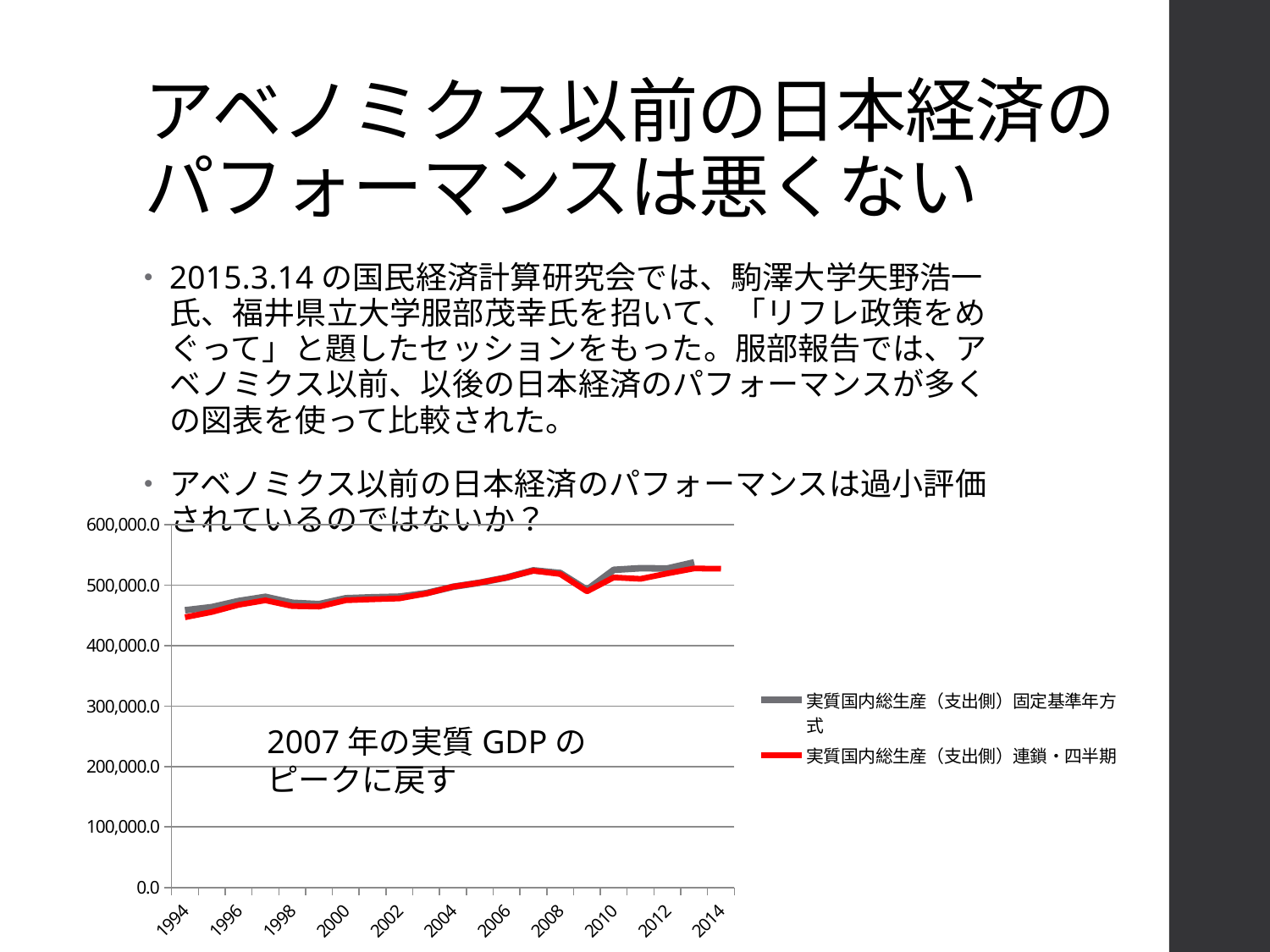
How many year labels are shown on the x axis of the chart? 11 Do the values of the red series (連鎖・四半期) generally rise or fall from 1994 to 2007? rise Which series is drawn in gray in the chart? 実質国内総生産（支出側）固定基準年方式 Is the value of the red series (連鎖・四半期) in 2007 greater or less than 400,000.0? greater Is the value of the gray series (固定基準年方式) in 2013 greater or less than 500,000.0? greater Is the value of the red series (連鎖・四半期) in 1994 greater or less than 500,000.0? less Which series is drawn in red in the chart? 実質国内総生産（支出側）連鎖・四半期 What is the highest value shown on the y axis of the chart? 600,000.0 How many series does the chart legend list? 2 In which year does the red series (連鎖・四半期) reach its lowest value? 1994 What kind of chart is shown on the slide? line chart In 1994, which series has the higher value, the gray 固定基準年方式 series or the red 連鎖・四半期 series? gray 固定基準年方式 series